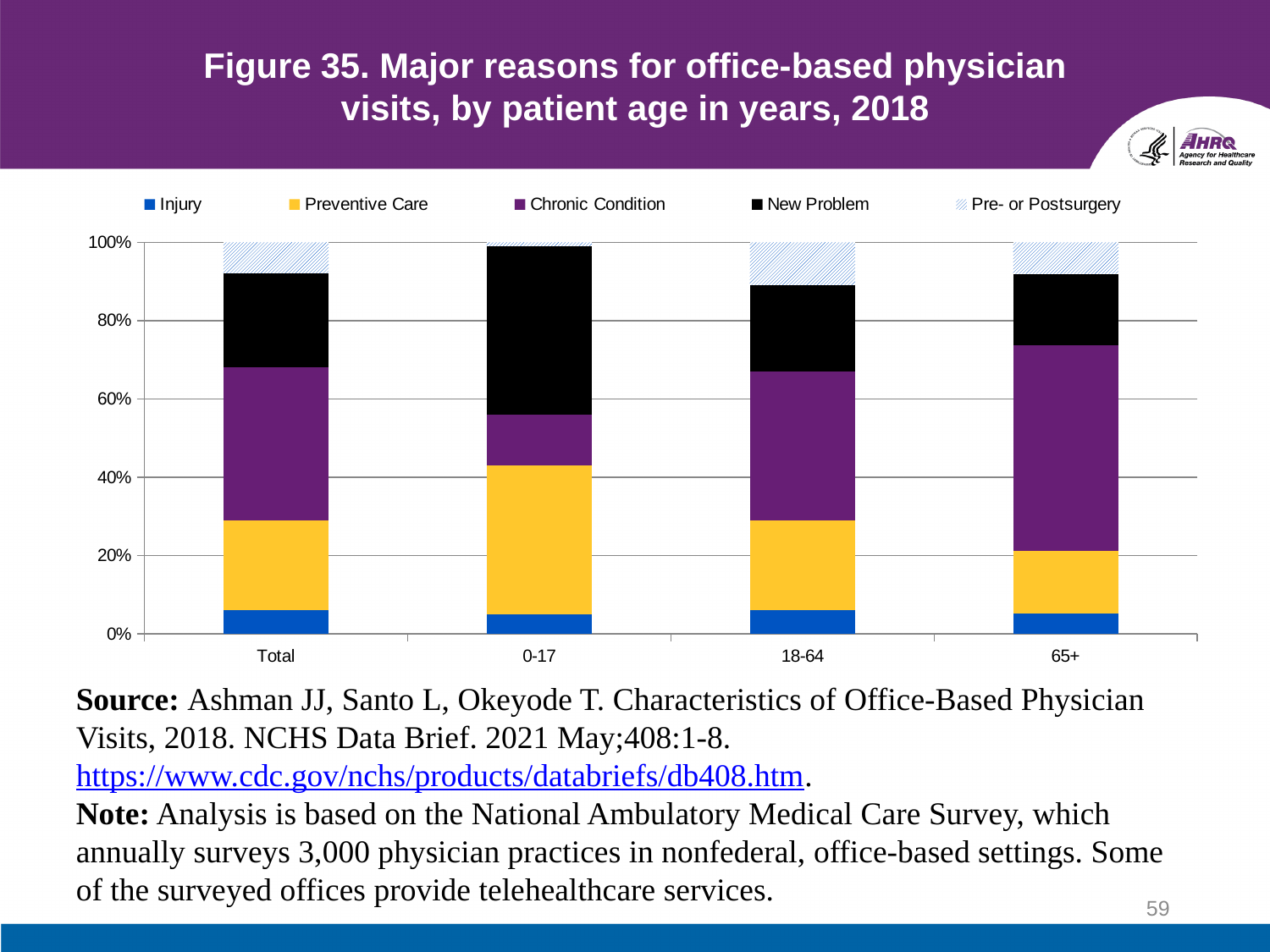
How many patient age categories are shown on the x axis? 4 Which age group has the largest Preventive Care segment? 0-17 What kind of chart is shown on the slide? Stacked bar chart Is the Preventive Care segment larger for the 0-17 group or the 65+ group? 0-17 Which age group has the largest New Problem segment? 0-17 Which age group has the largest Chronic Condition segment? 65+ Which series appears at the bottom of each stacked bar? Injury Which age group has the smallest Chronic Condition segment? 0-17 Which series is shown with a hatched pattern in the legend? Pre- or Postsurgery How many series does the legend list? 5 Is the Preventive Care segment for the 0-17 group greater or less than 20%? greater Is the Chronic Condition segment for the 65+ group greater or less than 40%? greater